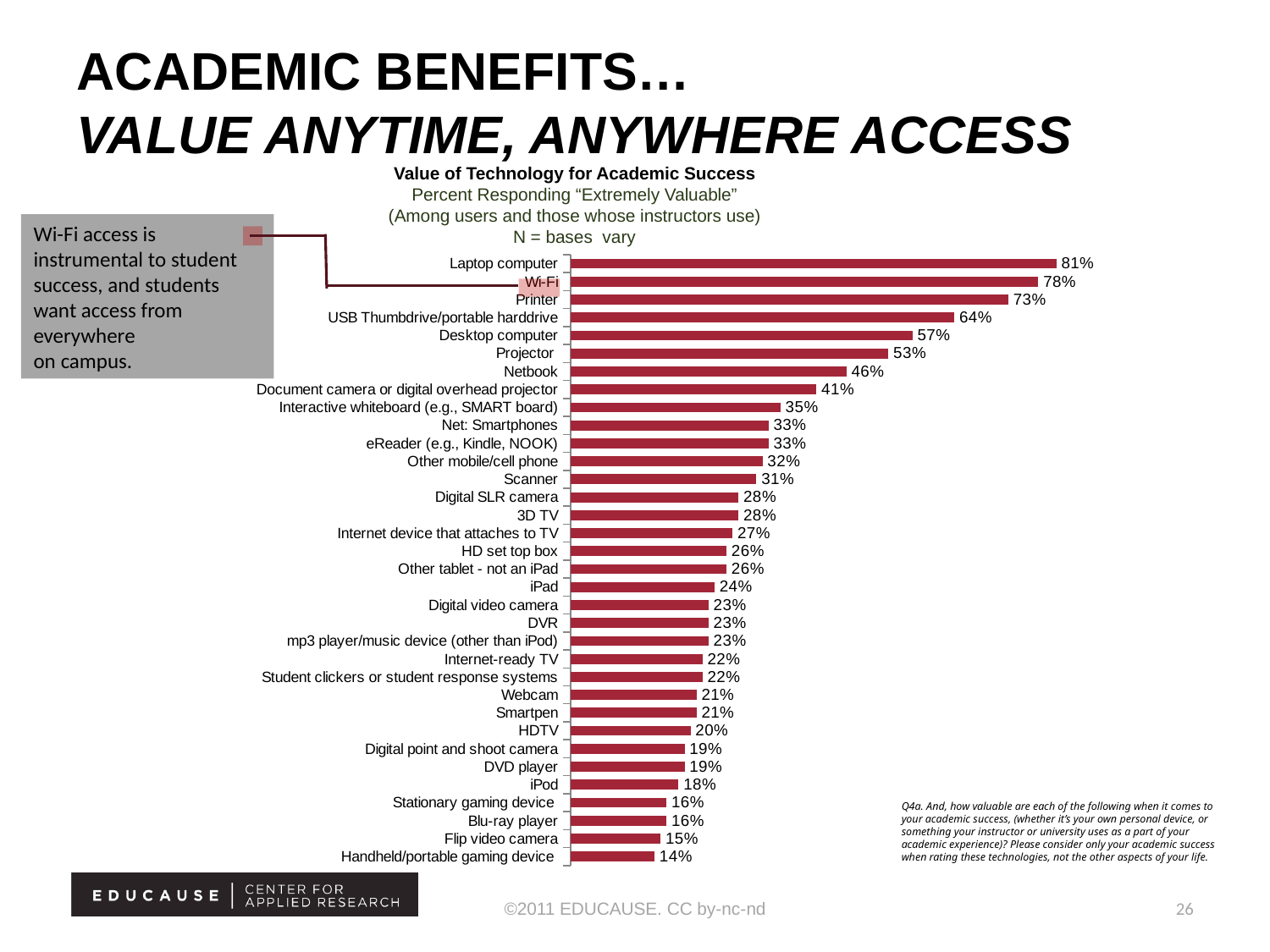
What is the value shown for Desktop computer? 57% What is the difference between the values for Laptop computer and Wi-Fi? 3% What is the title of the chart? Value of Technology for Academic Success Which has a higher value, iPod or Webcam? Webcam Which technology has the highest percentage responding "Extremely Valuable"? Laptop computer What is the value shown for iPad? 24% What type of chart is shown on the slide? Bar chart What is the difference between the values for Printer and Projector? 20% How many technologies are listed in the chart? 34 What percentage of respondents rated Wi-Fi as extremely valuable for academic success? 78% Which technology has the lowest percentage responding "Extremely Valuable"? Handheld/portable gaming device Which has a higher value, Netbook or Scanner? Netbook